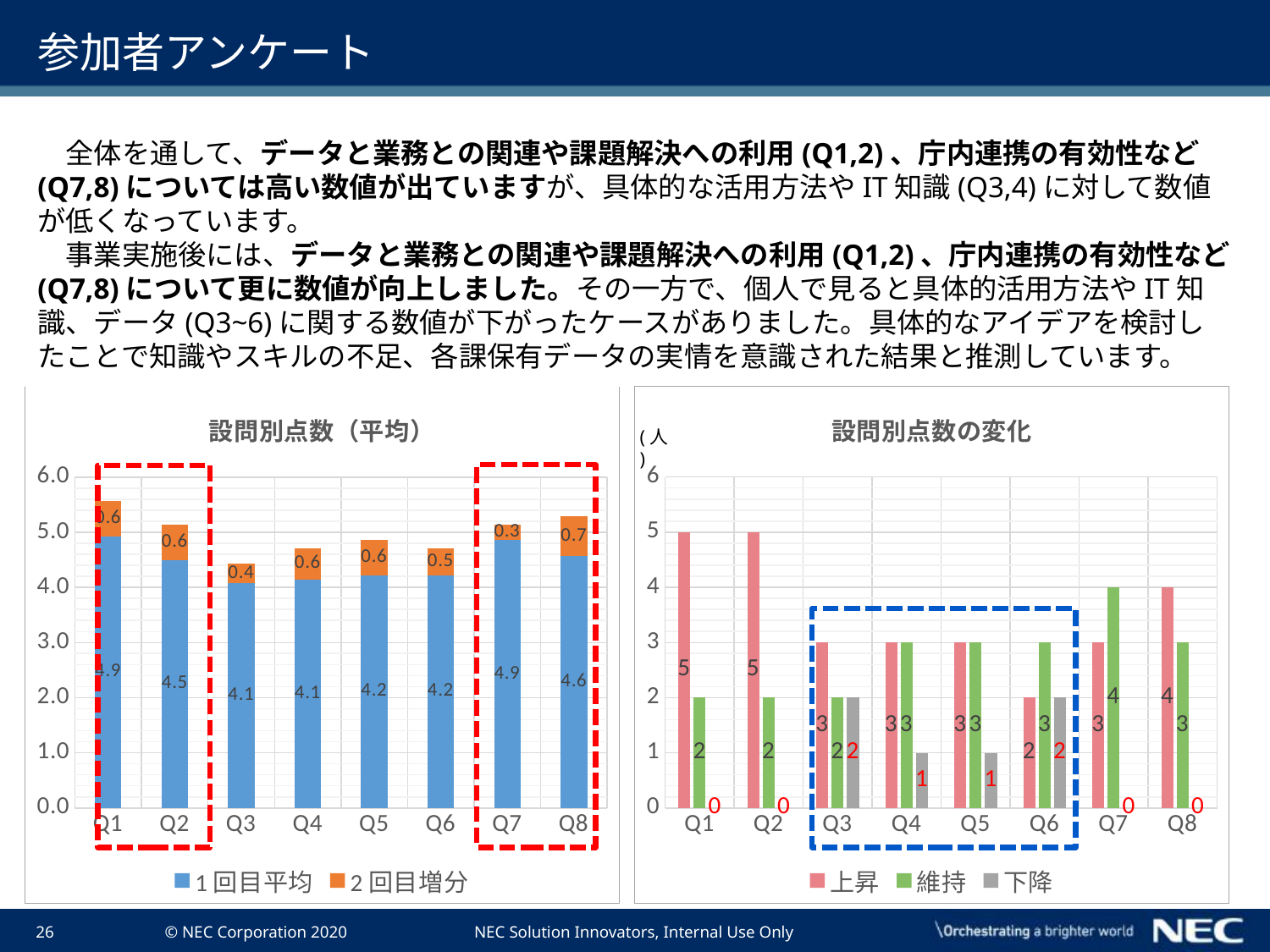
In the chart titled 設問別点数の変化, how many questions (categories) are shown on the x axis? 8 In the chart titled 設問別点数（平均）, which question has the smallest 2回目増分 value? Q7 In the chart titled 設問別点数（平均）, what kind of chart is it? Stacked bar chart In the chart titled 設問別点数（平均）, how many series does the legend list? 2 In the chart titled 設問別点数（平均）, what is the 2回目増分 value for Q8? 0.7 In the chart titled 設問別点数（平均）, what is the total stacked value for Q1? 5.5 In the chart titled 設問別点数（平均）, what is the difference between the 1回目平均 values for Q1 and Q3? 0.8 In the chart titled 設問別点数（平均）, what is the 1回目平均 value for Q2? 4.5 In the chart titled 設問別点数の変化, which question has the highest 維持 value? Q7 In the chart titled 設問別点数の変化, what is the 上昇 value for Q8? 4 In the chart titled 設問別点数の変化, what is the 下降 value for Q4? 1 In the chart titled 設問別点数の変化, is the 上昇 value for Q1 larger or the 上昇 value for Q6? Q1